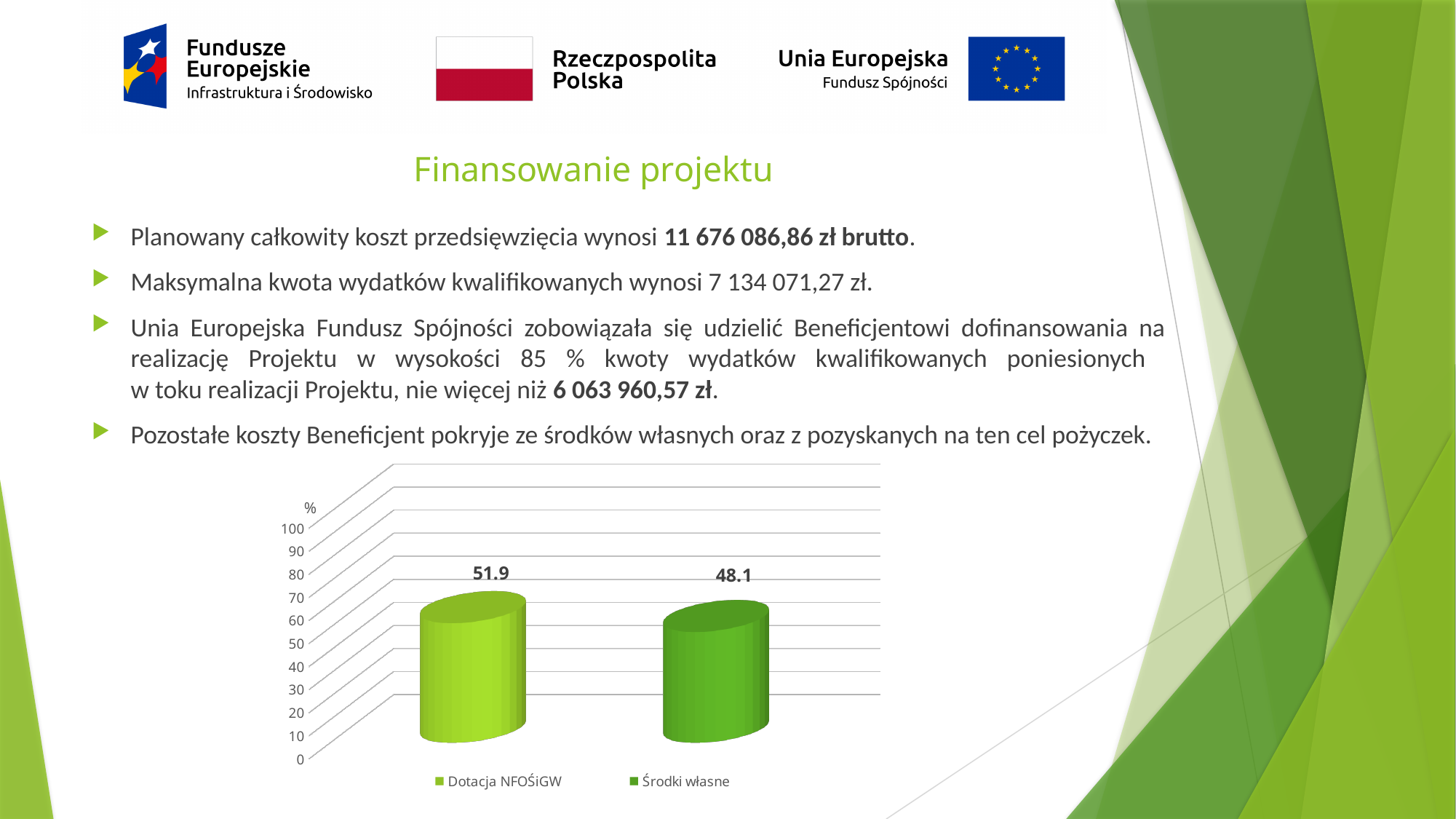
How many bars are plotted in the chart? 2 Is the value for Środki własne greater or less than 50? less Which bar in the chart is the lowest? Środki własne Which is larger, Dotacja NFOŚiGW or Środki własne? Dotacja NFOŚiGW What kind of chart is shown on the slide? bar chart What value is shown for Środki własne in the chart? 48.1 What value is shown for Dotacja NFOŚiGW in the chart? 51.9 What unit is labelled on the vertical axis of the chart? % Is the value for Dotacja NFOŚiGW greater or less than 50? greater How many entries does the chart legend list? 2 What is the difference between the values for Dotacja NFOŚiGW and Środki własne? 3.8 Which bar in the chart is the highest? Dotacja NFOŚiGW